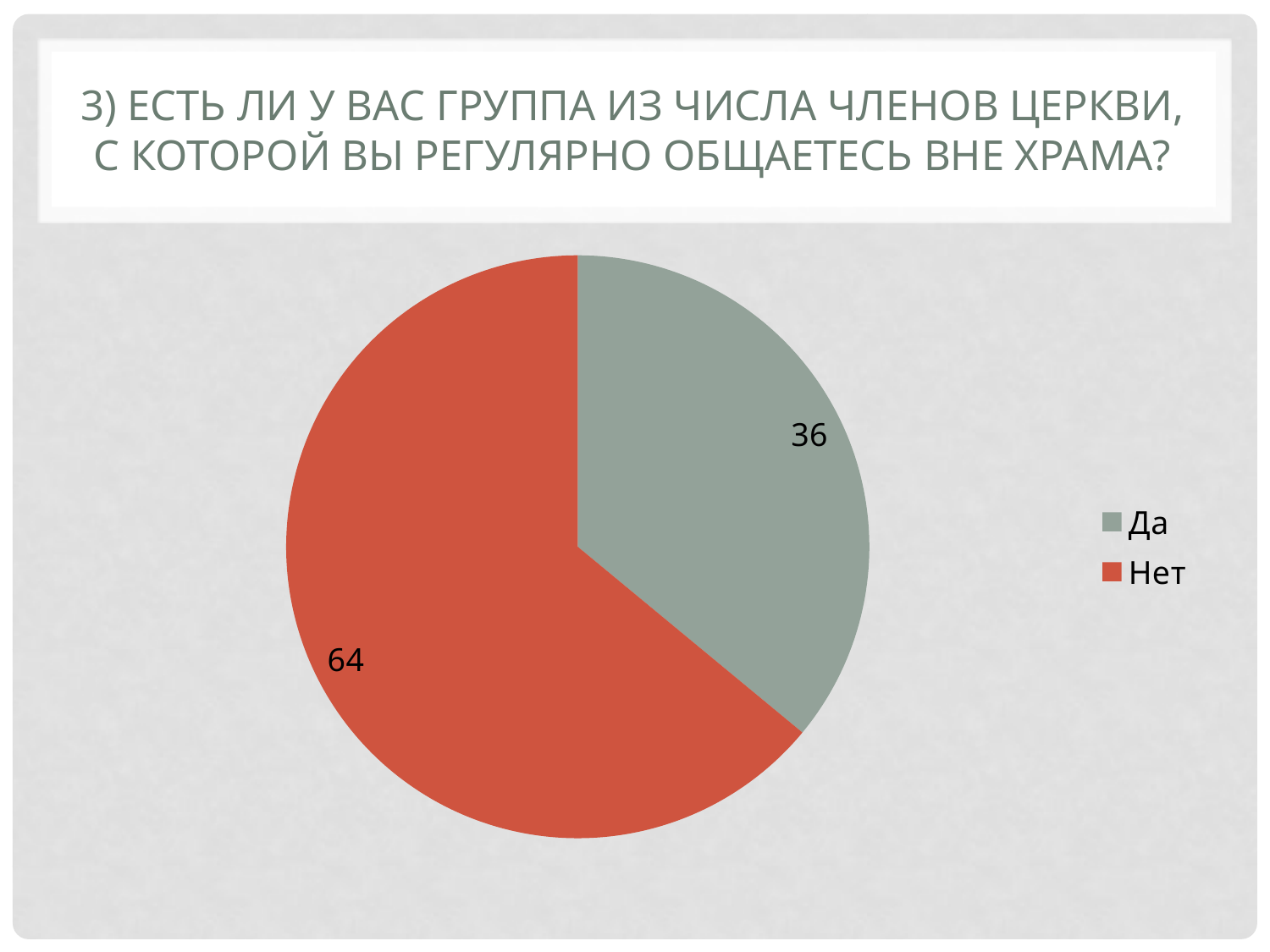
Which category has the largest slice? Нет How many slices does the pie chart have? 2 What is the value for the "Нет" slice? 64 What is the difference between the values for "Нет" and "Да"? 28 What is the value for the "Да" slice? 36 What share of the pie does the "Нет" slice represent? 64% What colour is the "Нет" slice? Red Which category has the smallest slice? Да How many entries does the legend list? 2 What kind of chart is shown on the slide? Pie chart What is the total of the two slice values? 100 Which is larger, the value for "Да" or the value for "Нет"? Нет